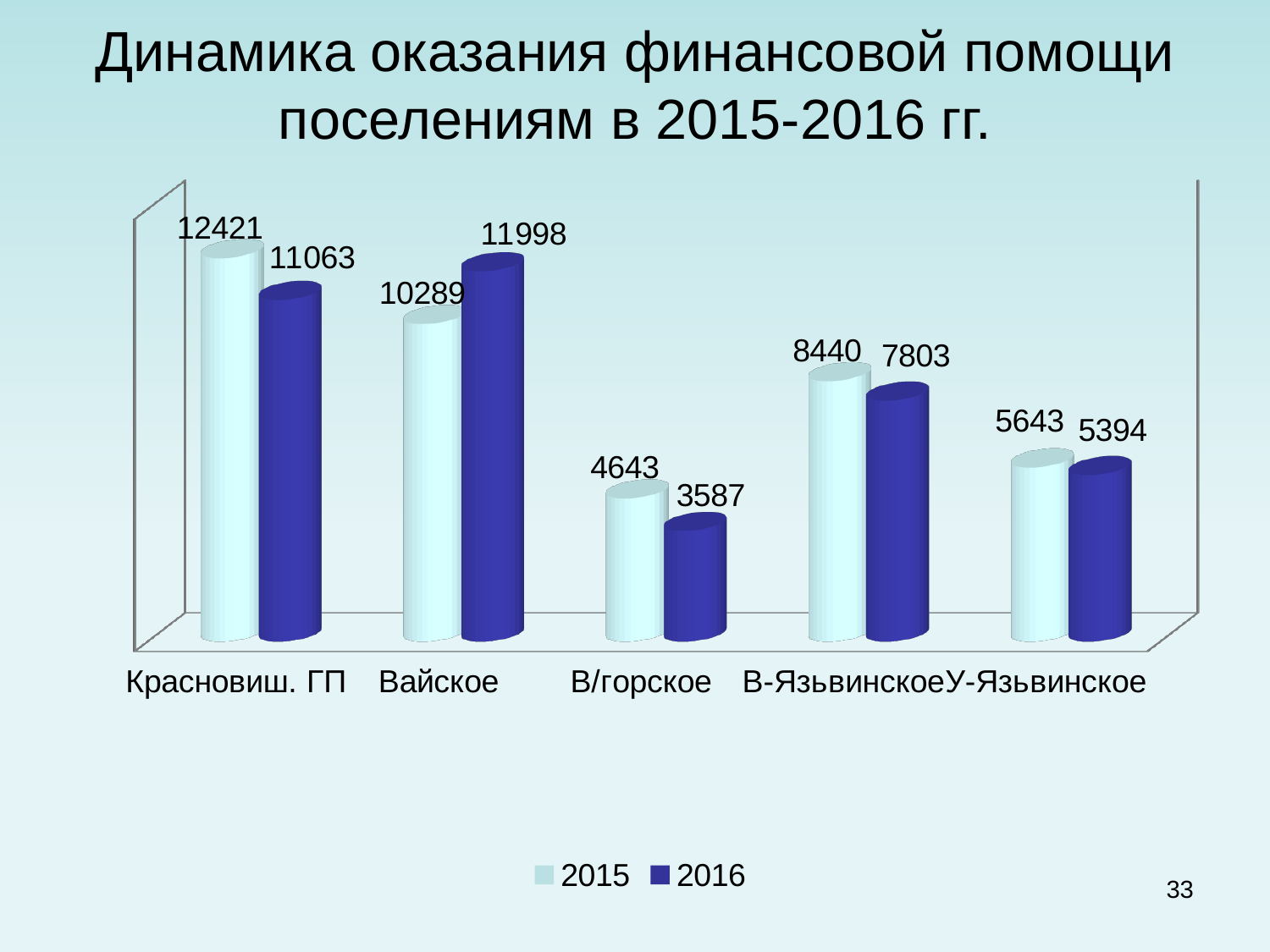
What are the two series listed in the legend? 2015 and 2016 What is the value for Вайское in 2016? 11998 Which category has the highest value in 2015? Красновиш. ГП What is the difference between the 2015 and 2016 values for В-Язьвинское? 637 Which category has the lowest value in 2016? В/горское What is the value for У-Язьвинское in 2015? 5643 What is the value for Красновиш. ГП in 2015? 12421 Which is larger for Вайское: the 2015 value or the 2016 value? 2016 What kind of chart is shown on the slide? Bar chart How many series does the legend list? 2 What is the value for В/горское in 2016? 3587 How many categories are shown on the x axis? 5